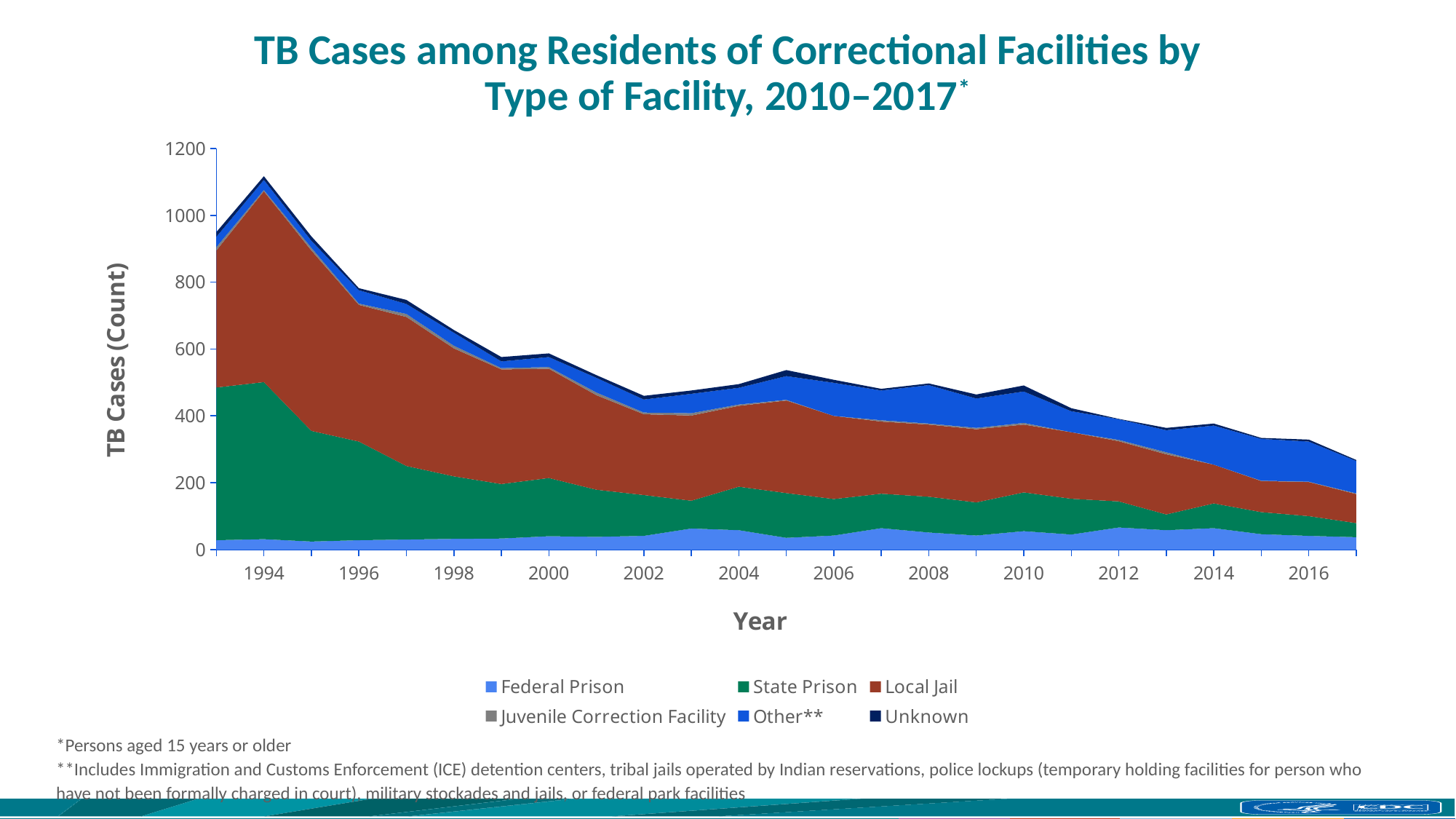
What kind of chart is shown on the slide? Stacked area chart How many series does the legend list? 6 Which series is shown in green in the legend? State Prison Which year has the lowest total number of TB cases? 2017 Is the total number of TB cases in 2016 greater or less than 400? less Is the total number of TB cases in 2010 greater or less than 400? greater What is the label of the y axis? TB Cases (Count) Is the total number of TB cases in 1994 greater or less than 1000? greater Do total TB cases generally rise or fall from 1994 to 2017? Fall Which year has the highest total number of TB cases? 1994